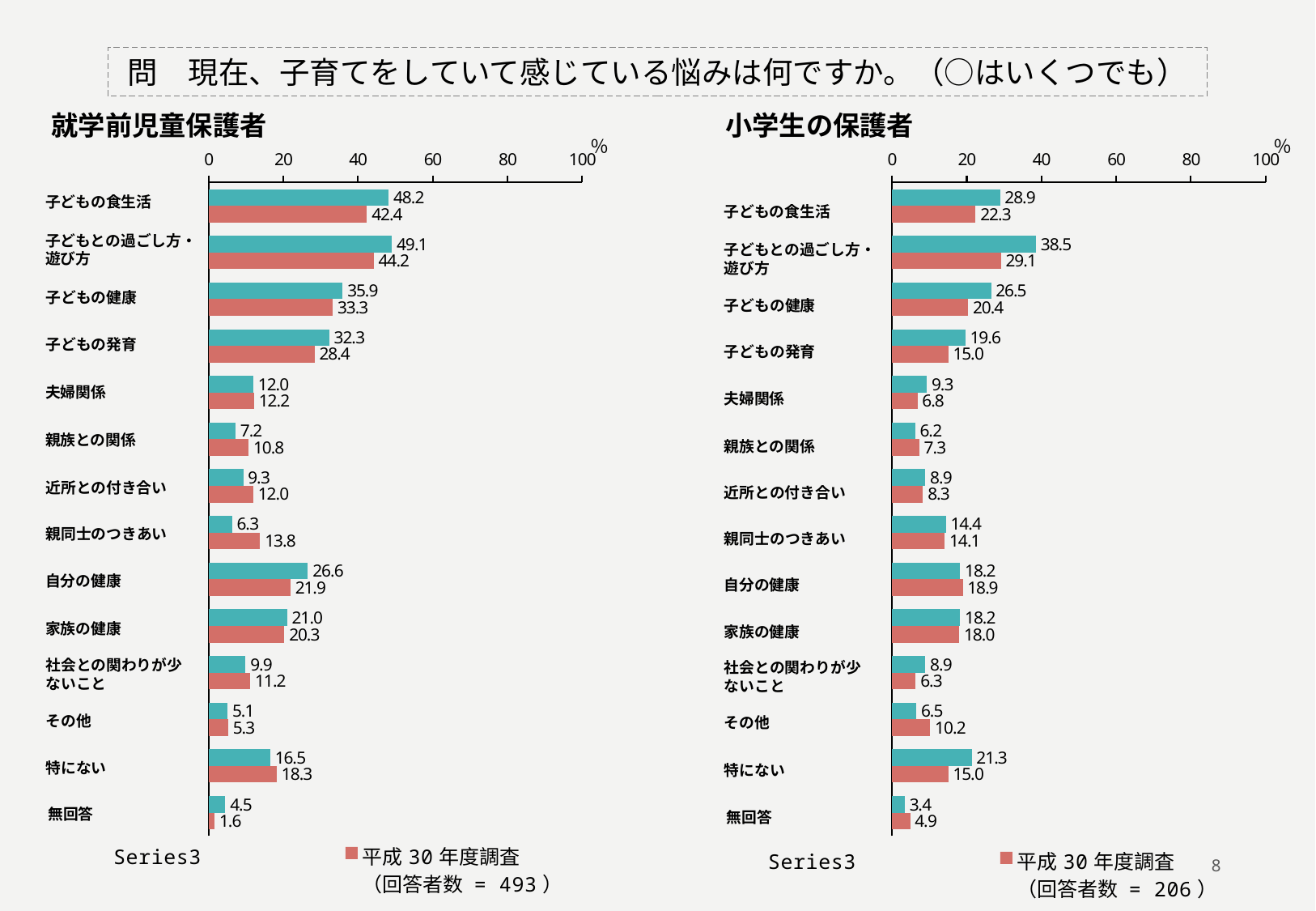
In the 小学生の保護者 chart, for その他, which series has the larger value: Series3 or 平成30年度調査? 平成30年度調査 What type of chart is the 就学前児童保護者 chart? Bar chart How many categories are shown in the 就学前児童保護者 chart? 14 In the 小学生の保護者 chart, what is the difference between the Series3 and 平成30年度調査 values for 子どもの食生活? 6.6 In the 就学前児童保護者 chart, what is the difference between the 平成30年度調査 and Series3 values for 親同士のつきあい? 7.5 In the 就学前児童保護者 chart, is the Series3 value for 子どもの健康 greater or less than 40? less In the 就学前児童保護者 chart, which category has the highest Series3 (teal) value? 子どもとの過ごし方・遊び方 In the 小学生の保護者 chart, which category has the lowest 平成30年度調査 value? 無回答 How many series does the legend of the 小学生の保護者 chart list? 2 In the 小学生の保護者 chart, what is the Series3 (teal) value for 子どもとの過ごし方・遊び方? 38.5 In the 就学前児童保護者 chart, what is the 平成30年度調査 value for 子どもの食生活? 42.4 In the 小学生の保護者 chart, what is the 平成30年度調査 value for 特にない? 15.0